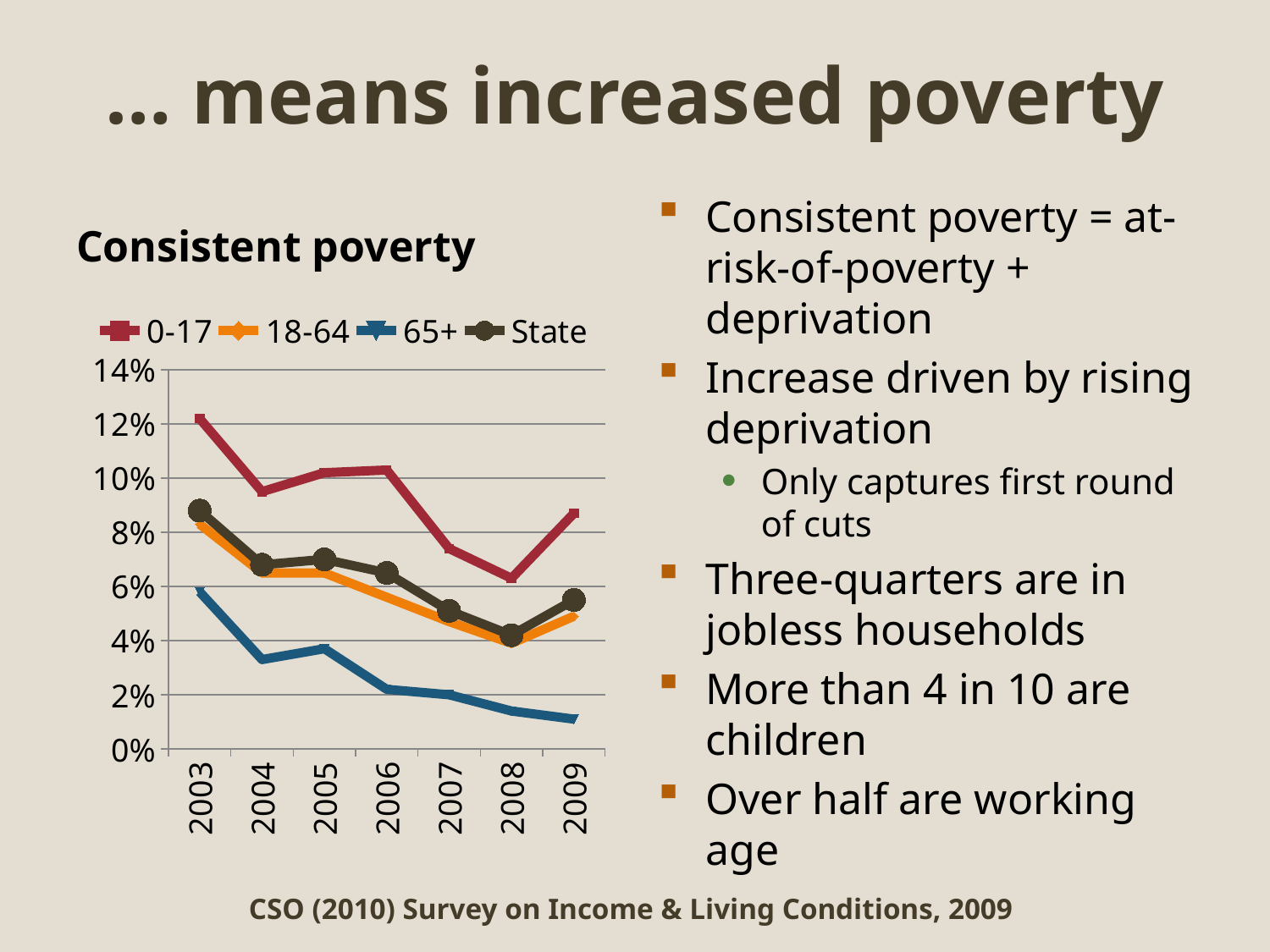
In which year is the 0-17 series at its highest in the 'Consistent poverty' chart? 2003 How many years are plotted along the x axis of the 'Consistent poverty' chart? 7 For the 0-17 series, which year has the larger value, 2008 or 2009? 2009 Which series has the highest value in 2003 in the 'Consistent poverty' chart? 0-17 How many series does the legend of the 'Consistent poverty' chart list? 4 What kind of chart is shown under the heading 'Consistent poverty'? line chart In which year is the 65+ series at its lowest in the 'Consistent poverty' chart? 2009 Which series has the lowest value in 2009 in the 'Consistent poverty' chart? 65+ Is the value for 65+ in 2009 greater or less than 2%? less Does the 65+ line rise or fall from 2003 to 2009 in the 'Consistent poverty' chart? fall Is the value for 18-64 in 2008 greater or less than 6%? less Is the value for 0-17 in 2003 greater or less than 10%? greater